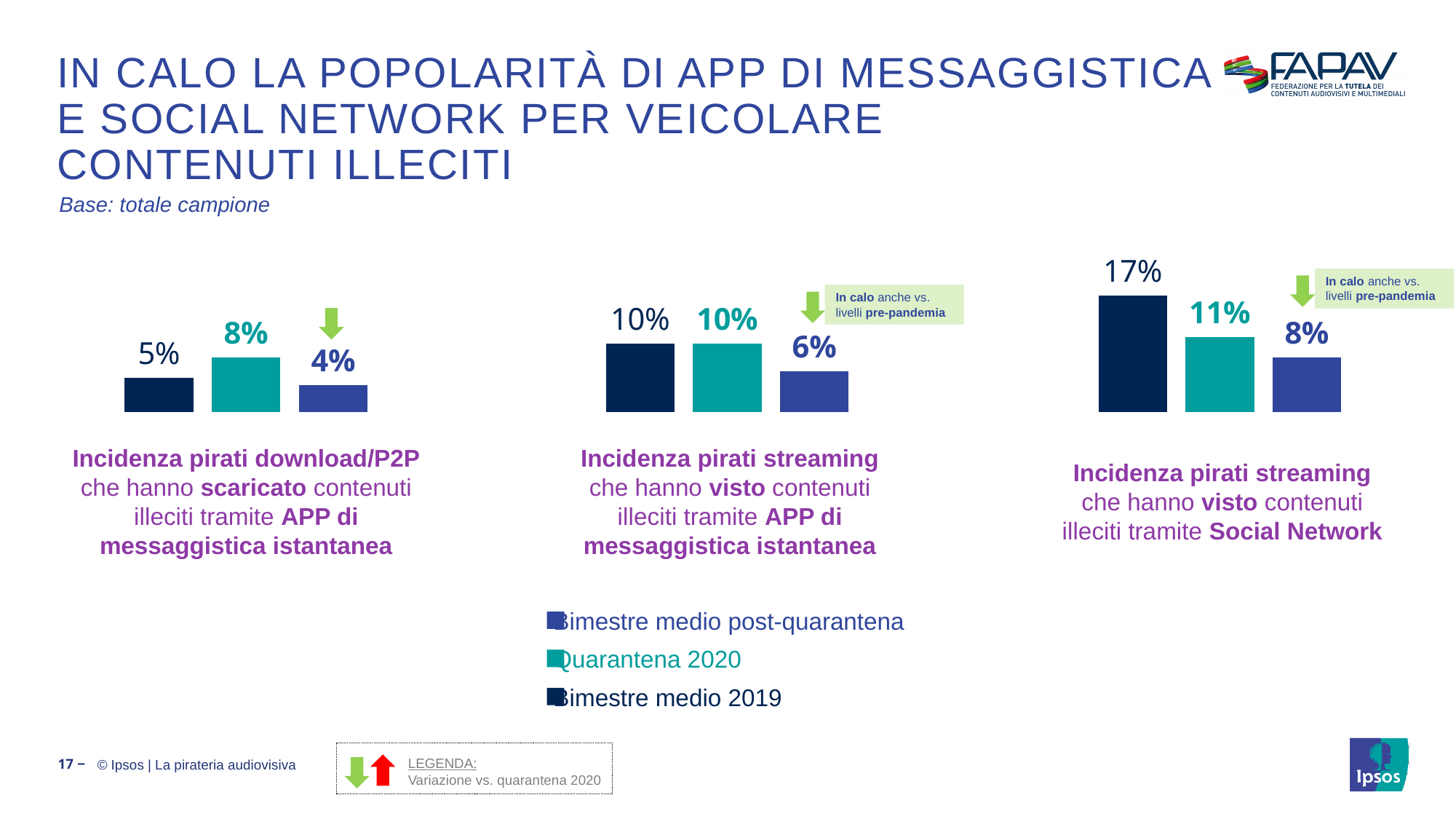
In the chart 'Incidenza pirati streaming ... Social Network', which period has the highest value? Bimestre medio 2019 In the chart 'Incidenza pirati streaming ... APP di messaggistica istantanea', what is the difference between the Quarantena 2020 value and the Bimestre medio post-quarantena value? 4 percentage points In the chart 'Incidenza pirati streaming ... APP di messaggistica istantanea', what is the value for Bimestre medio 2019? 10% In the chart 'Incidenza pirati streaming ... Social Network', what is the difference between the Bimestre medio 2019 value and the Bimestre medio post-quarantena value? 9 percentage points How many series does the legend list? 3 In the chart 'Incidenza pirati streaming ... Social Network', do the values rise or fall from Bimestre medio 2019 to Bimestre medio post-quarantena? Fall In the chart 'Incidenza pirati download/P2P ... APP di messaggistica istantanea', which is larger: the Bimestre medio 2019 value or the Quarantena 2020 value? Quarantena 2020 What kind of chart is used for 'Incidenza pirati streaming ... Social Network'? Bar chart In the chart 'Incidenza pirati download/P2P ... APP di messaggistica istantanea', which period has the lowest value? Bimestre medio post-quarantena In the chart 'Incidenza pirati download/P2P ... APP di messaggistica istantanea', what is the value for Bimestre medio post-quarantena? 4% In the chart 'Incidenza pirati streaming ... Social Network', what is the value for Bimestre medio 2019? 17% In the chart 'Incidenza pirati download/P2P ... APP di messaggistica istantanea', what is the value for Quarantena 2020? 8%